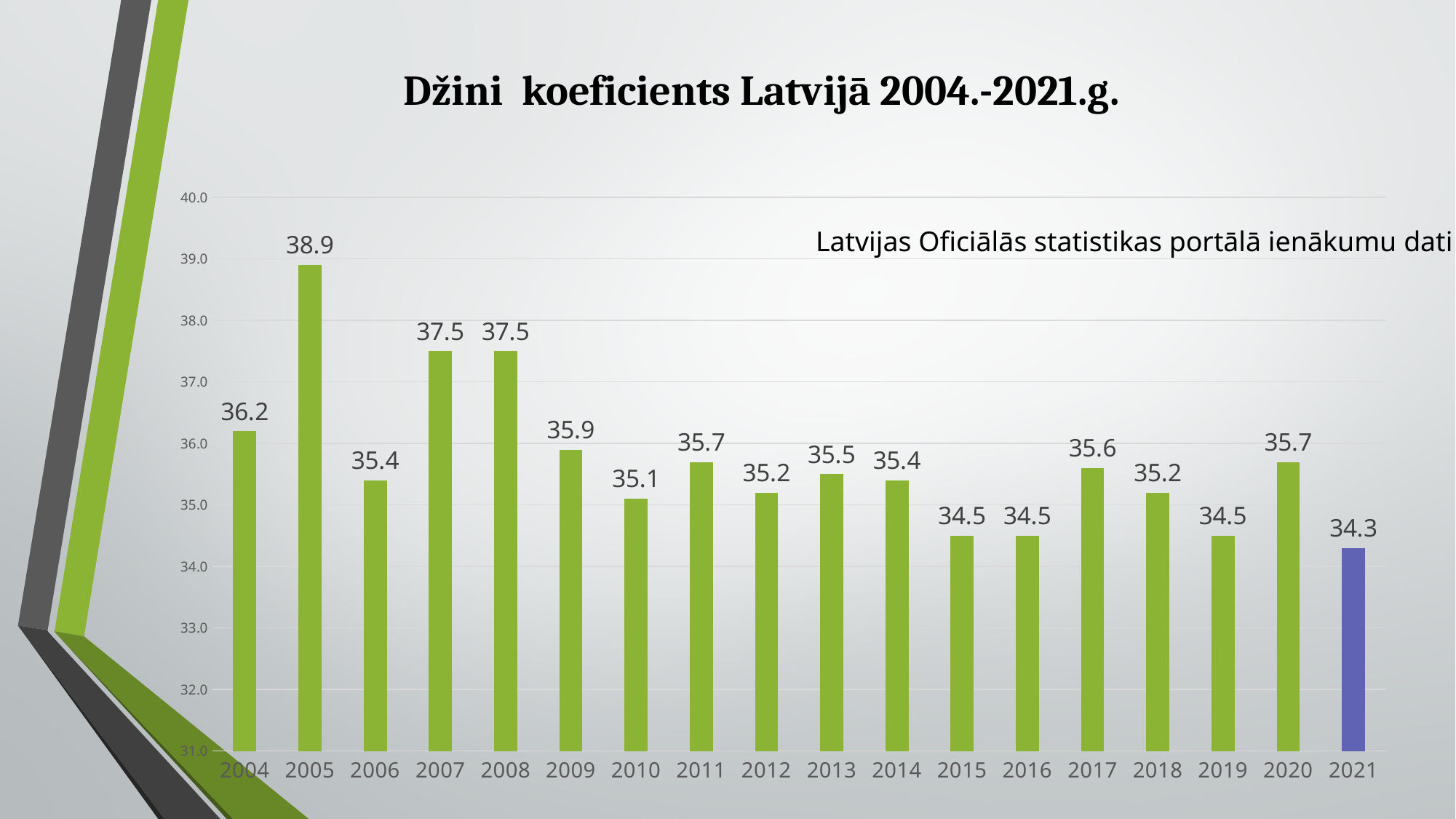
Which bar is coloured differently from the others? 2021 Which is larger, the value for 2011 or the value for 2014? 2011 What is the difference between the values for 2004 and 2009? 0.3 Is the value for 2008 greater or less than 37.0? greater What is the value shown for 2012? 35.2 Which year has the lowest value? 2021 Which year has the highest value? 2005 What kind of chart is shown on the slide? bar chart What is the Gini coefficient value shown for 2005? 38.9 What is the difference between the values for 2005 and 2021? 4.6 How many years are shown on the x axis? 18 What is the value shown for 2021? 34.3